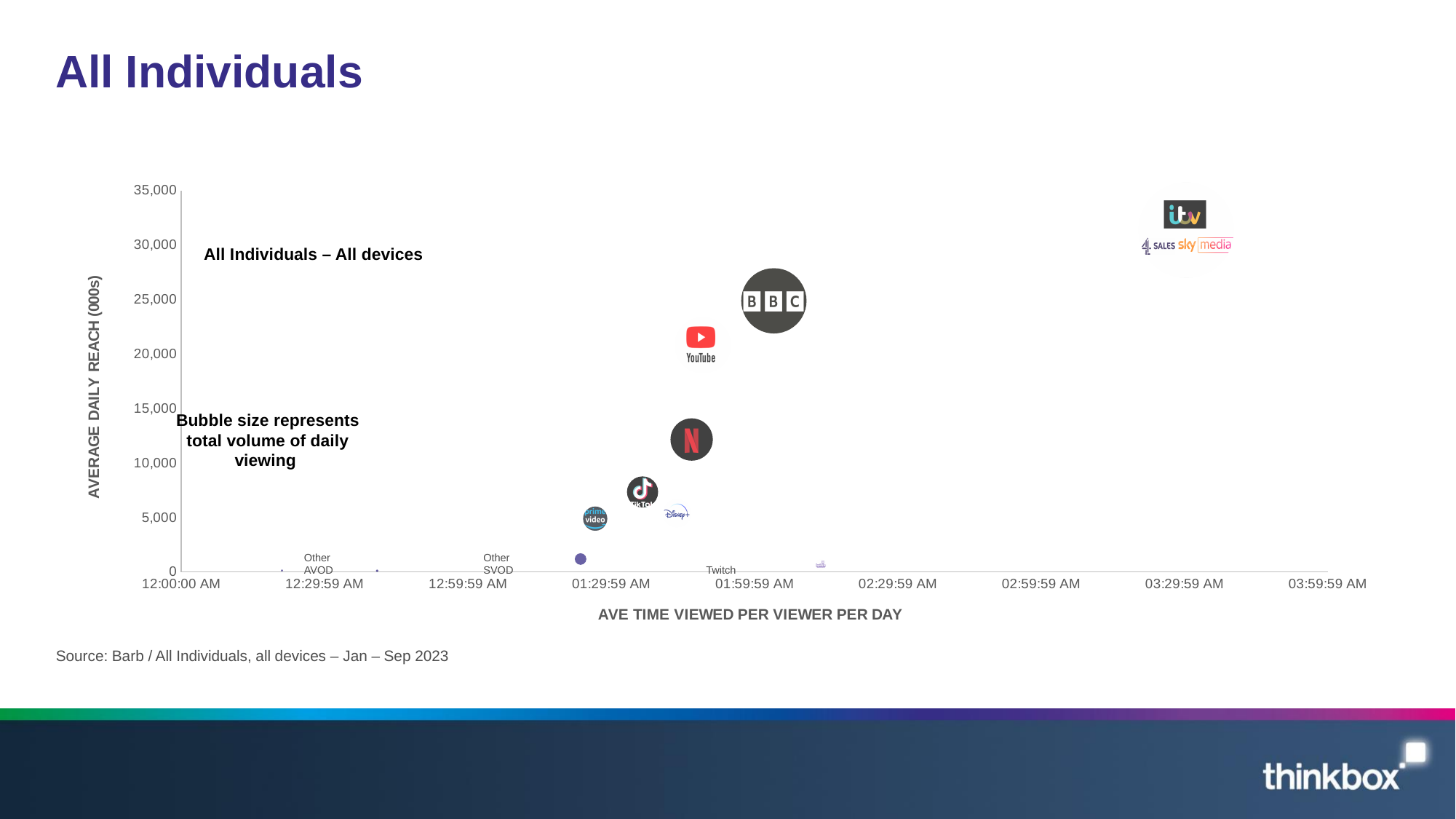
Is the average daily reach for YouTube greater or less than 15,000? greater Which has the higher average daily reach, Netflix or TikTok? Netflix What is the title of the vertical axis of the chart? AVERAGE DAILY REACH (000s) Is the average daily reach for Netflix greater or less than 15,000? less Is the average daily reach for Netflix greater or less than 10,000? greater What is the title of the horizontal axis of the chart? AVE TIME VIEWED PER VIEWER PER DAY What kind of chart is shown on the slide? Bubble chart Which has the higher average daily reach, BBC or YouTube? BBC Which has the higher average daily reach, Other SVOD or Prime Video? Prime Video